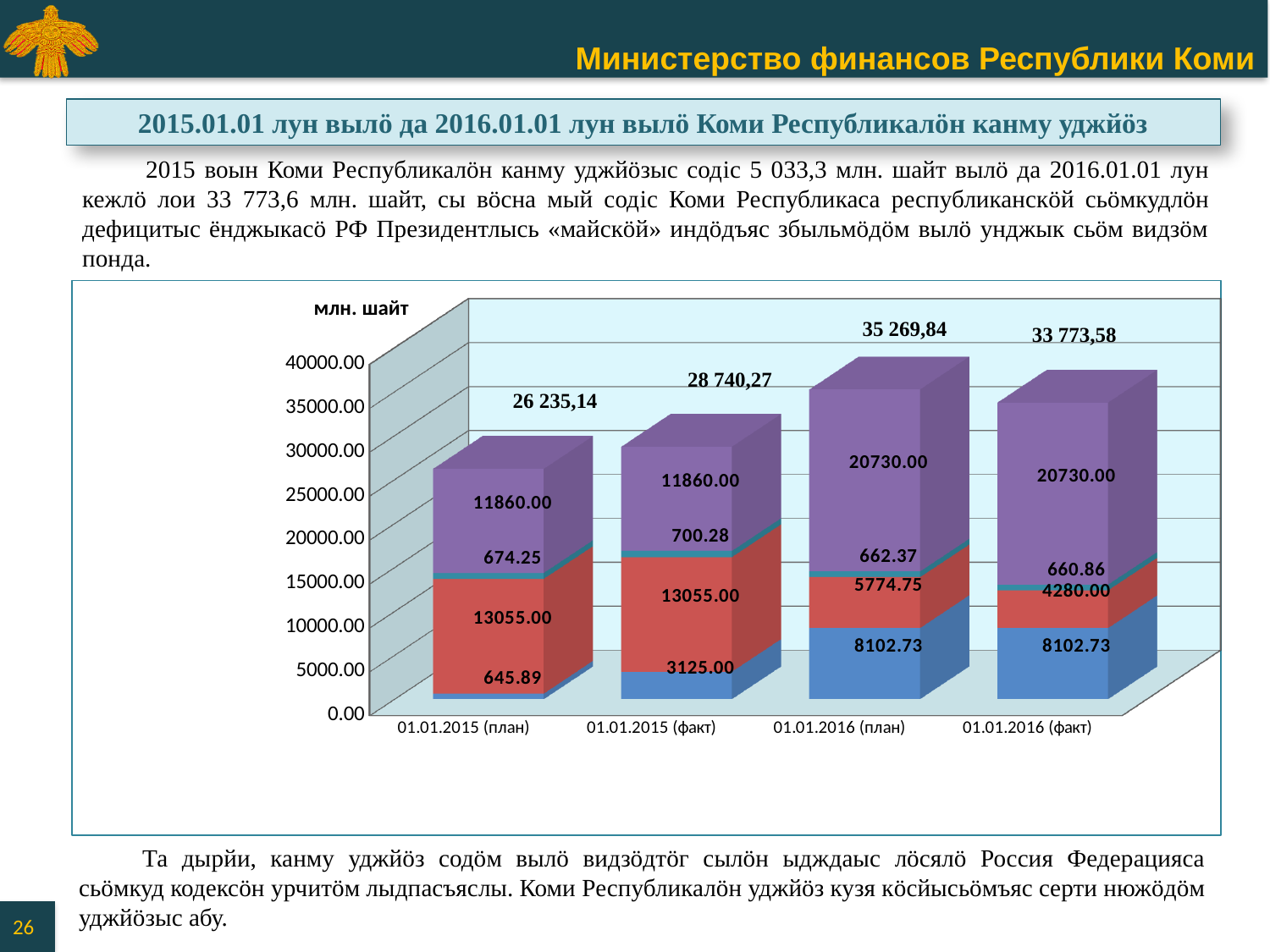
What is the total value printed above the bar for 01.01.2016 (план)? 35 269,84 What is the difference between the totals for 01.01.2016 (план) and 01.01.2016 (факт)? 1 496,26 What is the total value printed above the bar for 01.01.2015 (факт)? 28 740,27 Which is larger: the red segment for 01.01.2016 (план) or the red segment for 01.01.2016 (факт)? 01.01.2016 (план) What is the value of the red segment for 01.01.2016 (план)? 5774.75 What is the value of the blue (bottom) segment for 01.01.2015 (план)? 645.89 Which category has the highest total value? 01.01.2016 (план) What is the value of the purple (top) segment for 01.01.2016 (факт)? 20730.00 Which category has the lowest total value? 01.01.2015 (план) What kind of chart is shown on the slide? Stacked bar chart How many categories are shown on the x axis? 4 What unit label is shown at the top of the chart's vertical axis? млн. шайт